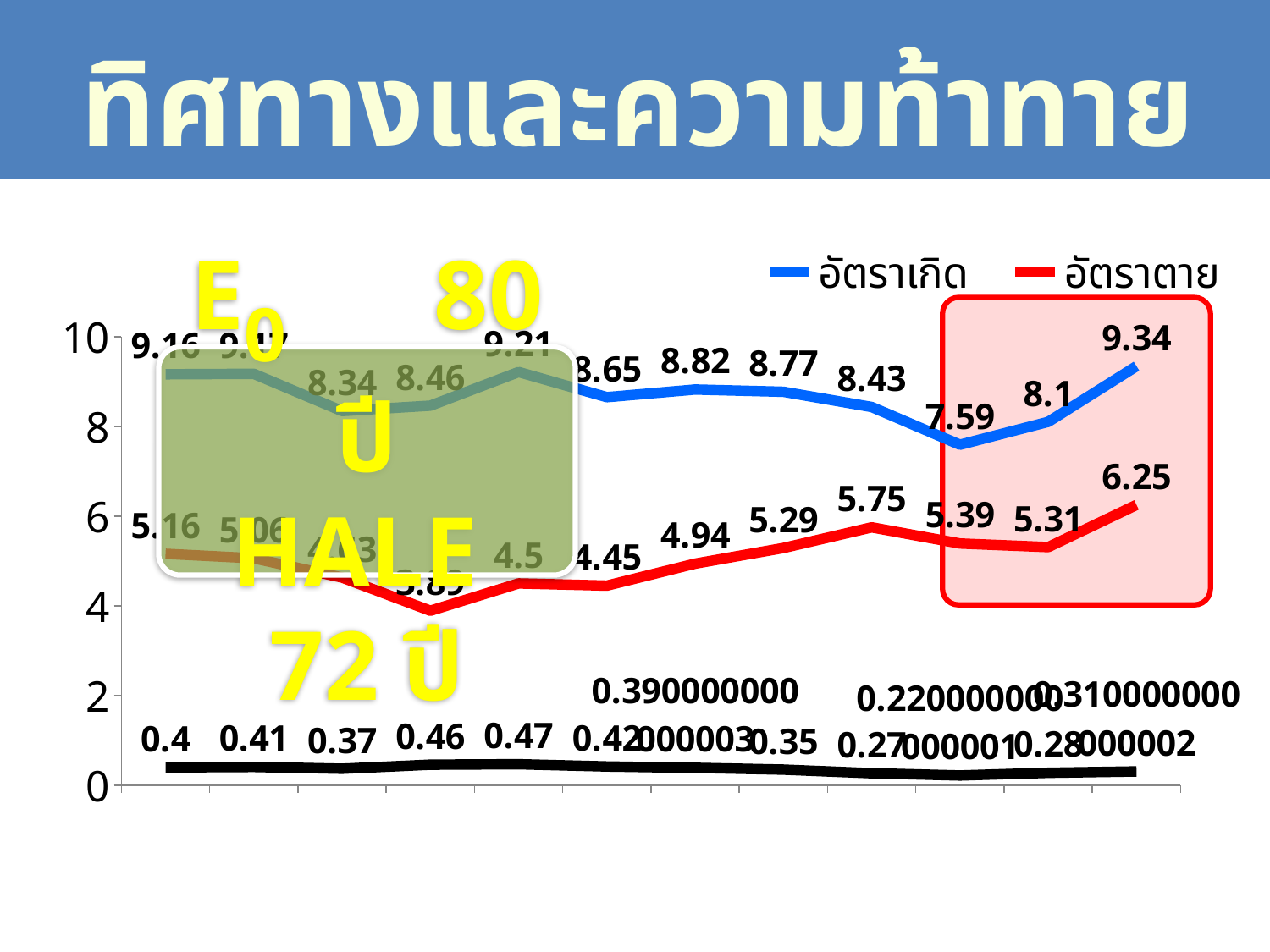
Over the last three points inside the red highlighted box, does the อัตราเกิด (blue) line rise or fall? rise Is the lowest value on the อัตราตาย (red) line greater or less than 4? less What is the highest labelled value on the อัตราเกิด (blue) line? 9.34 What is the lowest labelled value on the อัตราตาย (red) line? 3.89 What is the highest labelled value on the อัตราตาย (red) line? 6.25 How many data points are plotted on the อัตราเกิด (blue) line? 12 How many series does the chart legend list? 2 What kind of chart is shown on the slide? line chart What is the lowest labelled value on the อัตราเกิด (blue) line? 7.59 At the rightmost point of the chart, which series has the larger value, อัตราเกิด or อัตราตาย? อัตราเกิด At the rightmost point of the chart, what is the difference between the อัตราเกิด value and the อัตราตาย value? 3.09 What are the two series named in the chart legend? อัตราเกิด and อัตราตาย